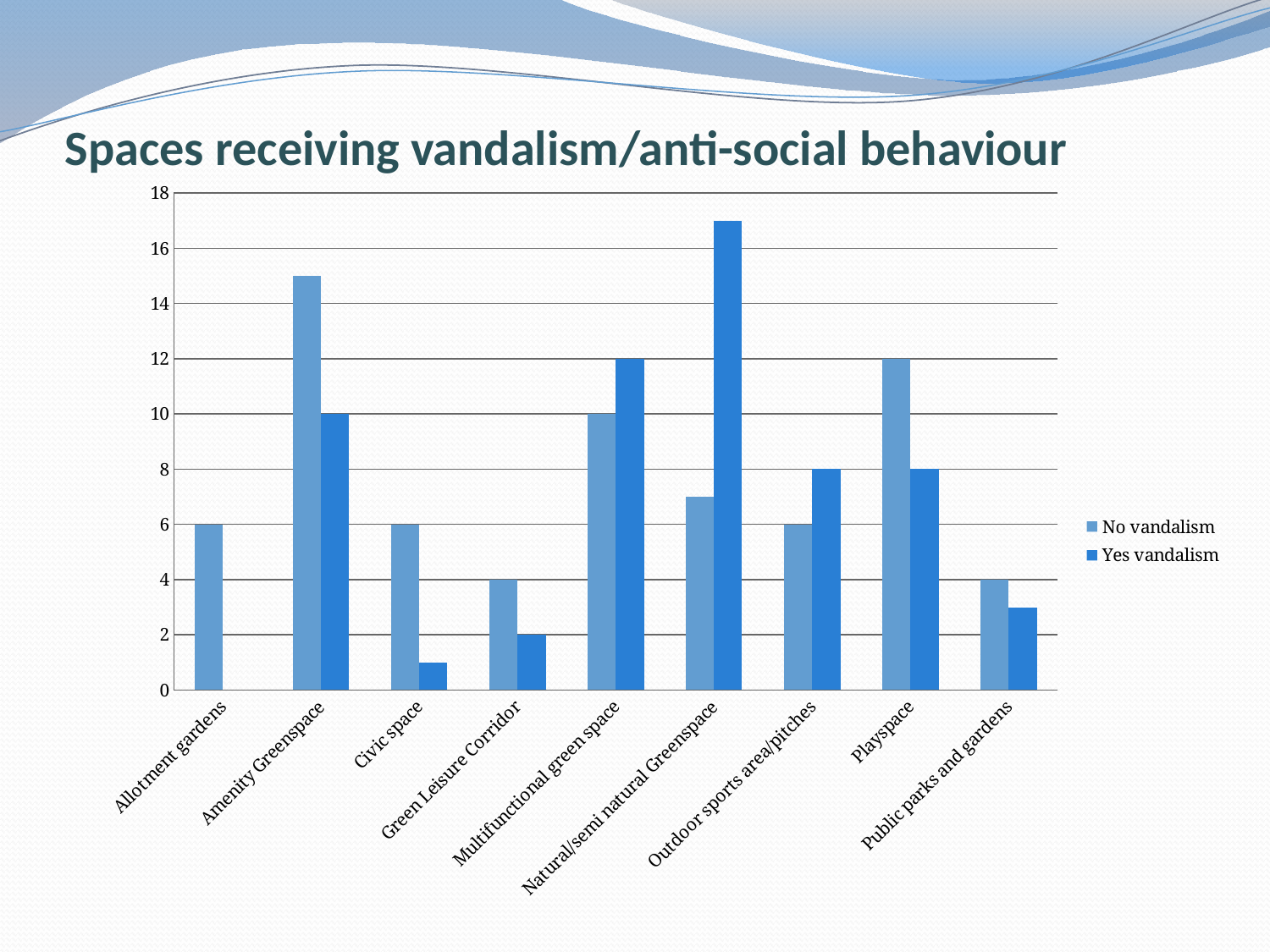
What is the 'Yes vandalism' value for Amenity Greenspace? 10 Is the 'Yes vandalism' value for Natural/semi natural Greenspace greater or less than 16? greater What is the difference between the 'No vandalism' value for Playspace and the 'Yes vandalism' value for Playspace? 4 How many series does the legend list? 2 Which category has the highest 'Yes vandalism' value? Natural/semi natural Greenspace Which is larger for Outdoor sports area/pitches: the 'No vandalism' value or the 'Yes vandalism' value? Yes vandalism How many categories are shown on the x axis? 9 What kind of chart is shown on the slide? bar chart Which category has the highest 'No vandalism' value? Amenity Greenspace What is the 'No vandalism' value for Allotment gardens? 6 What is the 'No vandalism' value for Playspace? 12 What is the 'Yes vandalism' value for Multifunctional green space? 12